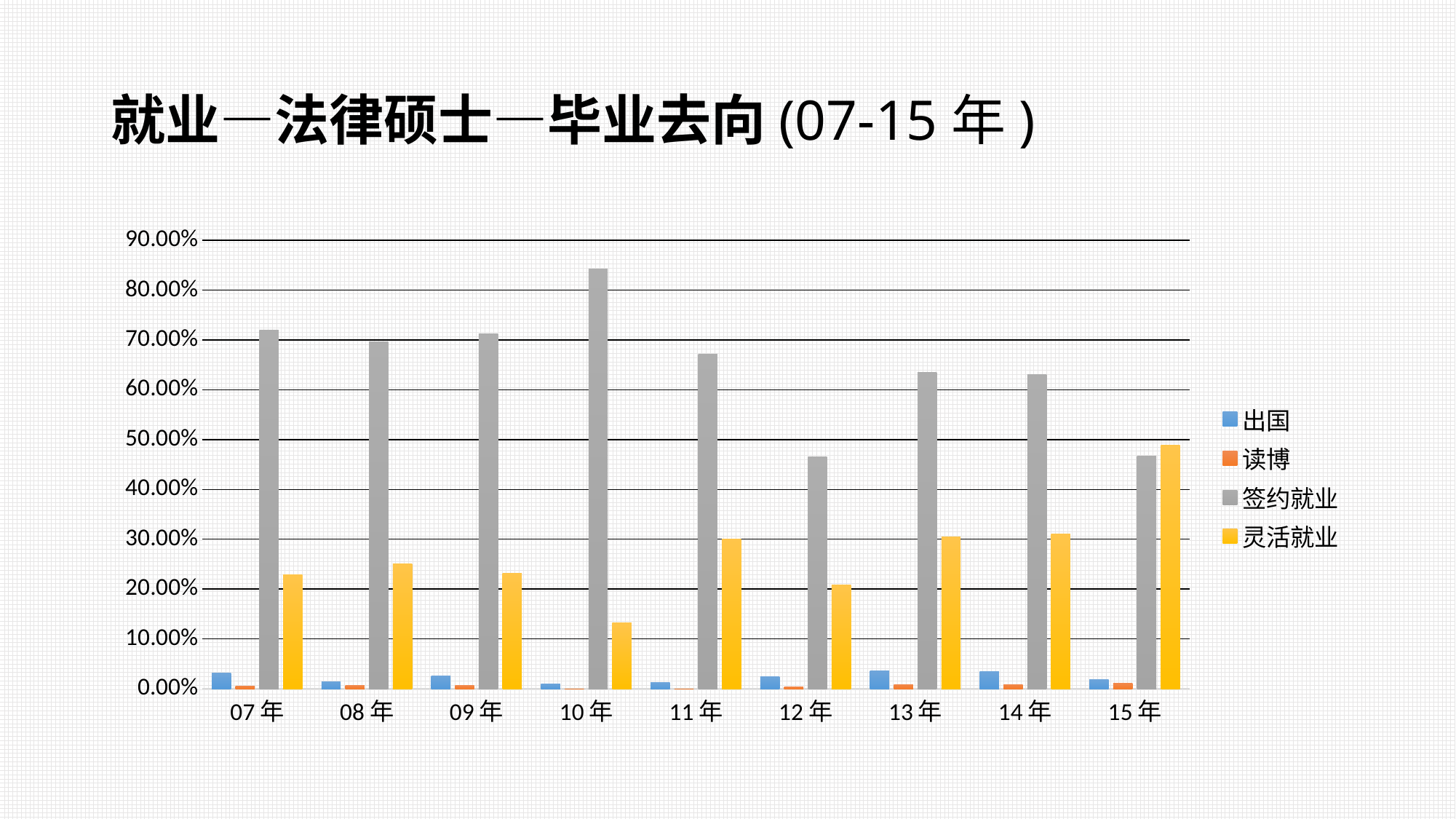
Does the value for 签约就业 rise or fall from 10 年 to 12 年? fall What kind of chart is shown on the slide? bar chart Is the value for 灵活就业 in 15 年 greater or less than 40.00%? greater How many series does the legend list? 4 In which year is the value for 灵活就业 the lowest? 10 年 Is the value for 签约就业 in 12 年 greater or less than 50.00%? less In 12 年, which is larger: 签约就业 or 灵活就业? 签约就业 Is the value for 签约就业 in 10 年 greater or less than 80.00%? greater In which year is the value for 灵活就业 the highest? 15 年 In which year is the value for 签约就业 the highest? 10 年 How many years are shown along the x axis? 9